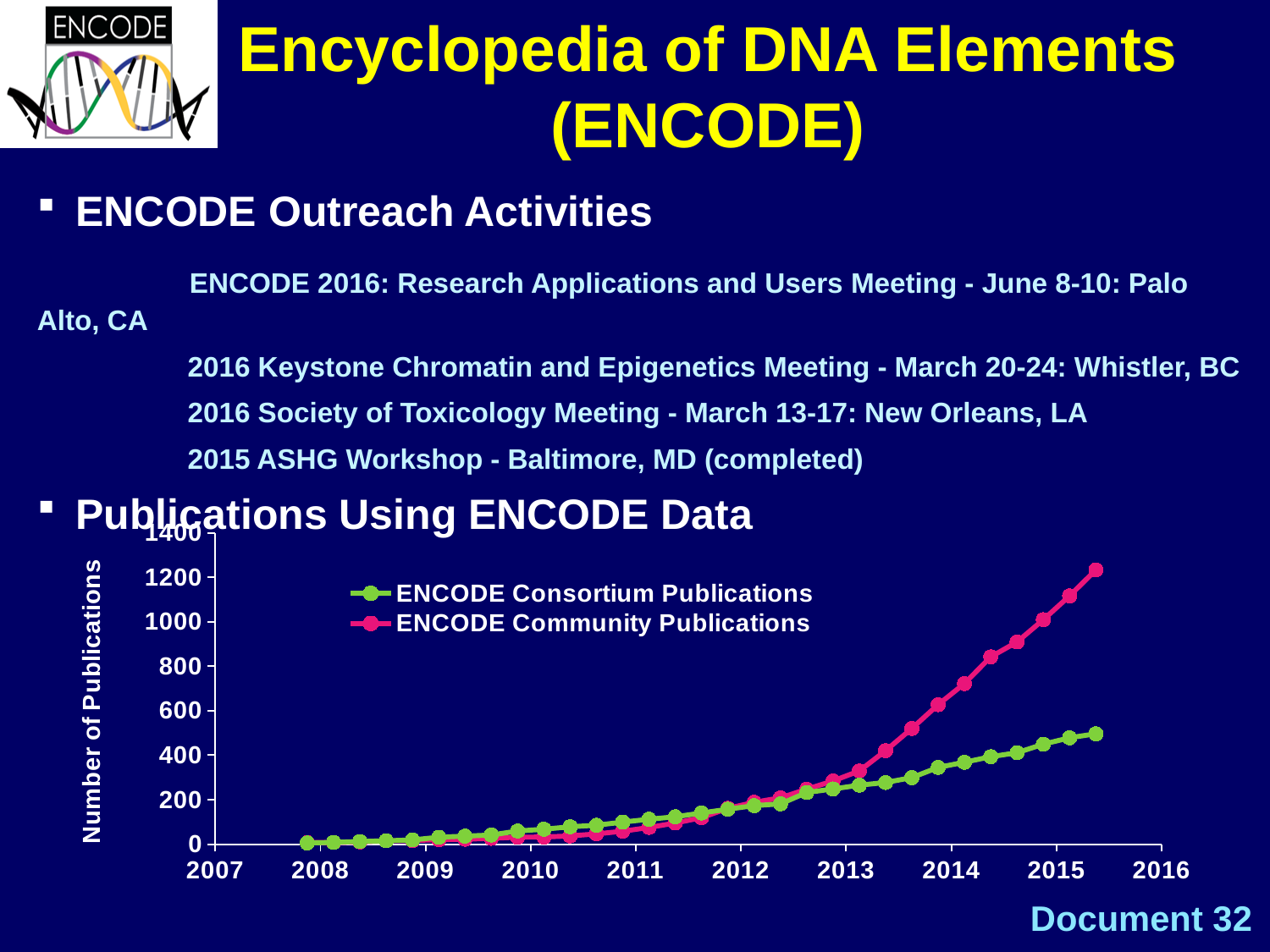
Is the final value of ENCODE Consortium Publications greater or less than 600? less Is the final value of ENCODE Community Publications greater or less than 1000? greater Which series reaches the highest value on the publications chart? ENCODE Community Publications Is the value of ENCODE Community Publications at 2014 greater or less than 400? greater Which series has the higher value at the right end of the publications chart? ENCODE Community Publications Do the values of ENCODE Community Publications rise or fall from 2008 to 2015? rise What are the two series named in the legend of the publications chart? ENCODE Consortium Publications and ENCODE Community Publications How many series does the legend of the publications chart list? 2 What is the label on the vertical axis of the publications chart? Number of Publications What kind of chart is shown under "Publications Using ENCODE Data"? line chart